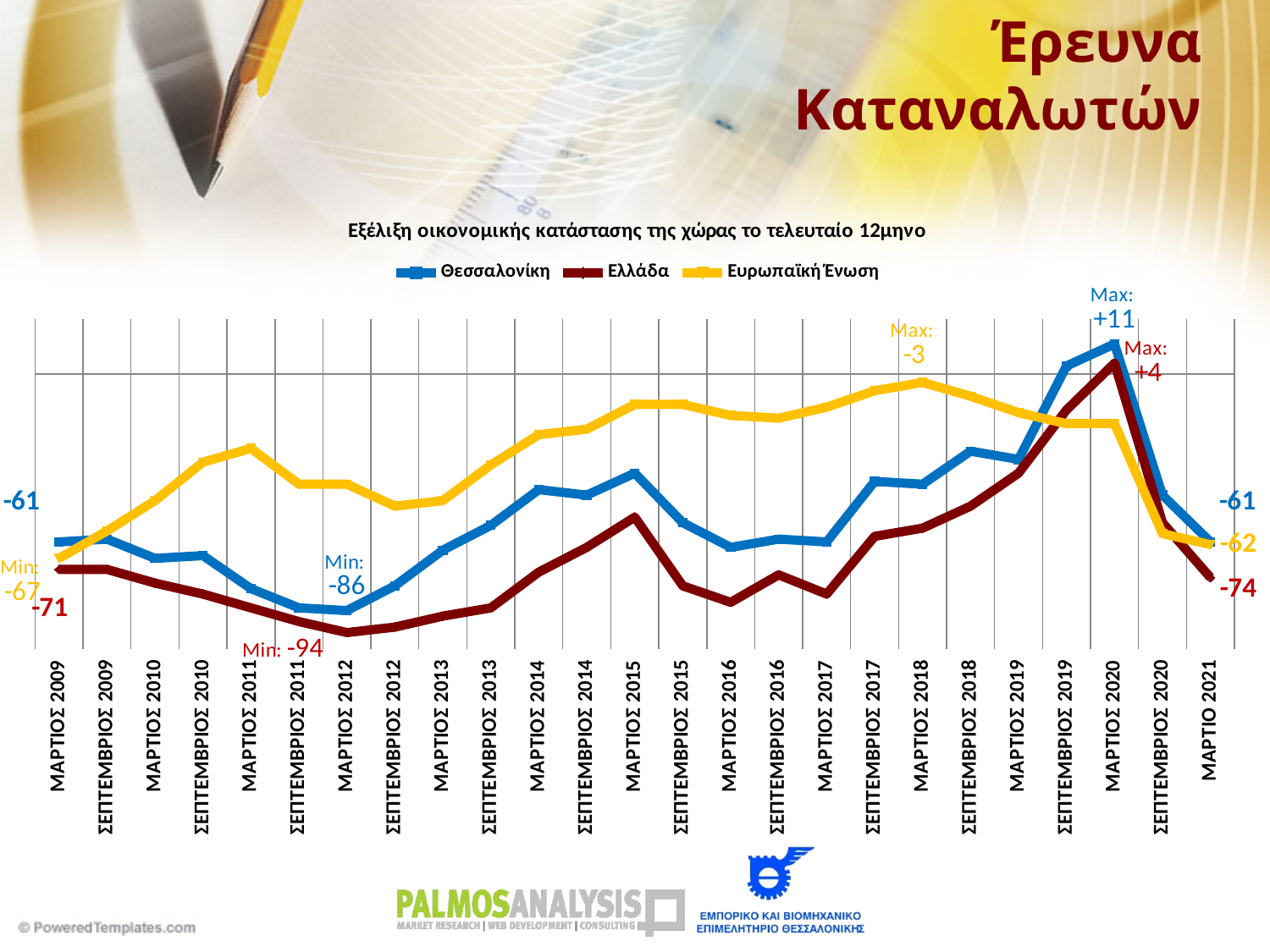
What is the maximum value labelled for the Ευρωπαϊκή Ένωση series? -3 What is the value for Ευρωπαϊκή Ένωση at ΜΑΡΤΙΟ 2021? -62 What is the title of the chart? Εξέλιξη οικονομικής κατάστασης της χώρας το τελευταίο 12μηνο At ΜΑΡΤΙΟ 2021, which series has the higher value, Θεσσαλονίκη or Ελλάδα? Θεσσαλονίκη What is the difference between the labelled maximum of Θεσσαλονίκη (+11) and the labelled maximum of Ελλάδα (+4)? 7 What is the maximum value labelled for the Θεσσαλονίκη series? +11 How many series does the legend list? 3 What kind of chart is shown on the slide? Line chart What is the value for Θεσσαλονίκη at ΜΑΡΤΙΟΣ 2009? -61 What is the value for Ελλάδα at ΜΑΡΤΙΟ 2021? -74 What is the minimum value labelled for the Θεσσαλονίκη series? -86 What is the minimum value labelled for the Ελλάδα series? -94